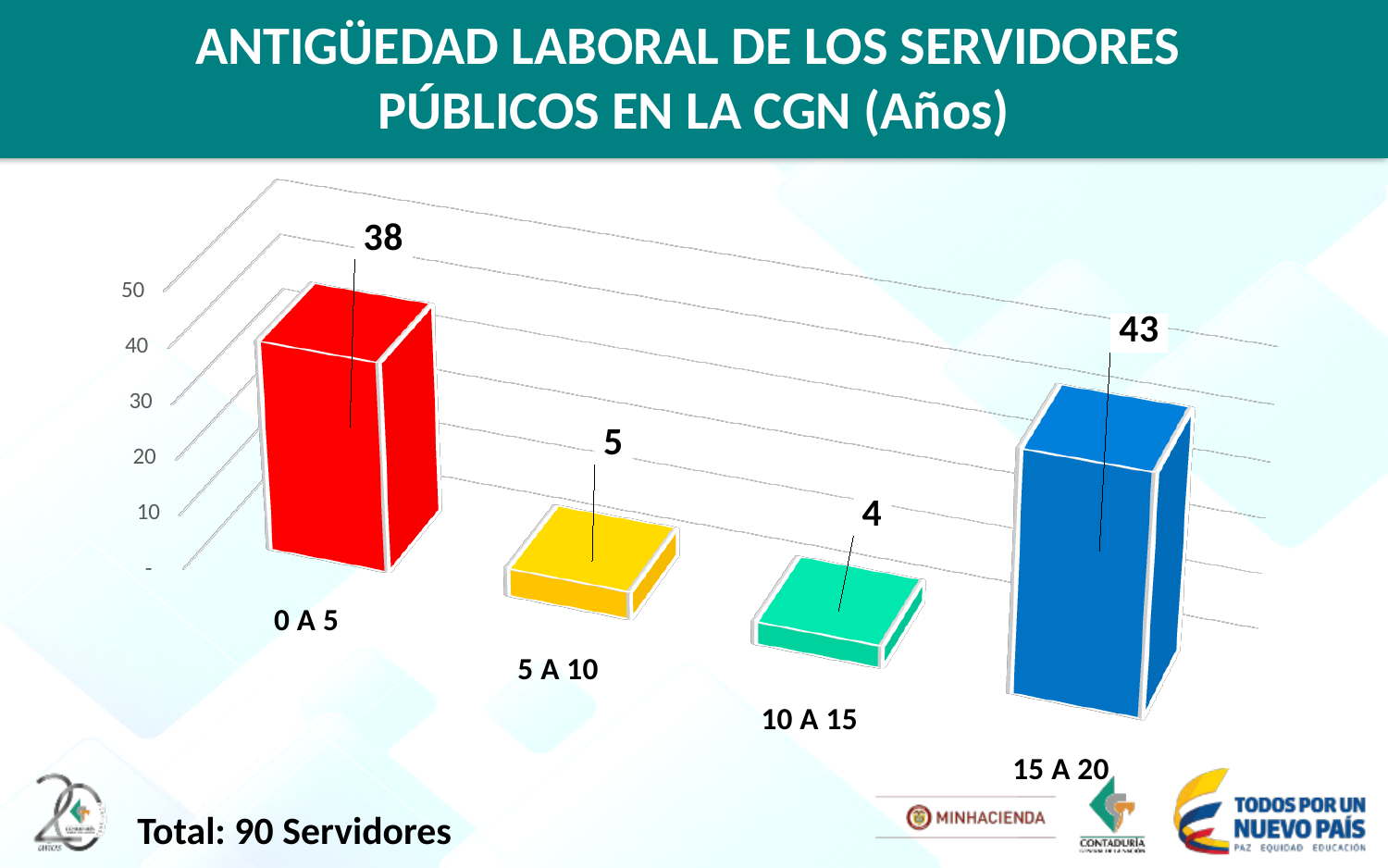
What kind of chart is shown on the slide? bar chart What is the value for the 15 A 20 category? 43 Which category has the highest value? 15 A 20 What is the title of the chart? ANTIGÜEDAD LABORAL DE LOS SERVIDORES PÚBLICOS EN LA CGN (Años) Which is larger, the value for 0 A 5 or the value for 15 A 20? 15 A 20 How many categories are shown in the chart? 4 What is the difference between the values for 15 A 20 and 0 A 5? 5 What is the value for the 5 A 10 category? 5 Which category has the lowest value? 10 A 15 What colour is the bar for the 5 A 10 category? yellow What is the value for the 0 A 5 category? 38 What is the value for the 10 A 15 category? 4